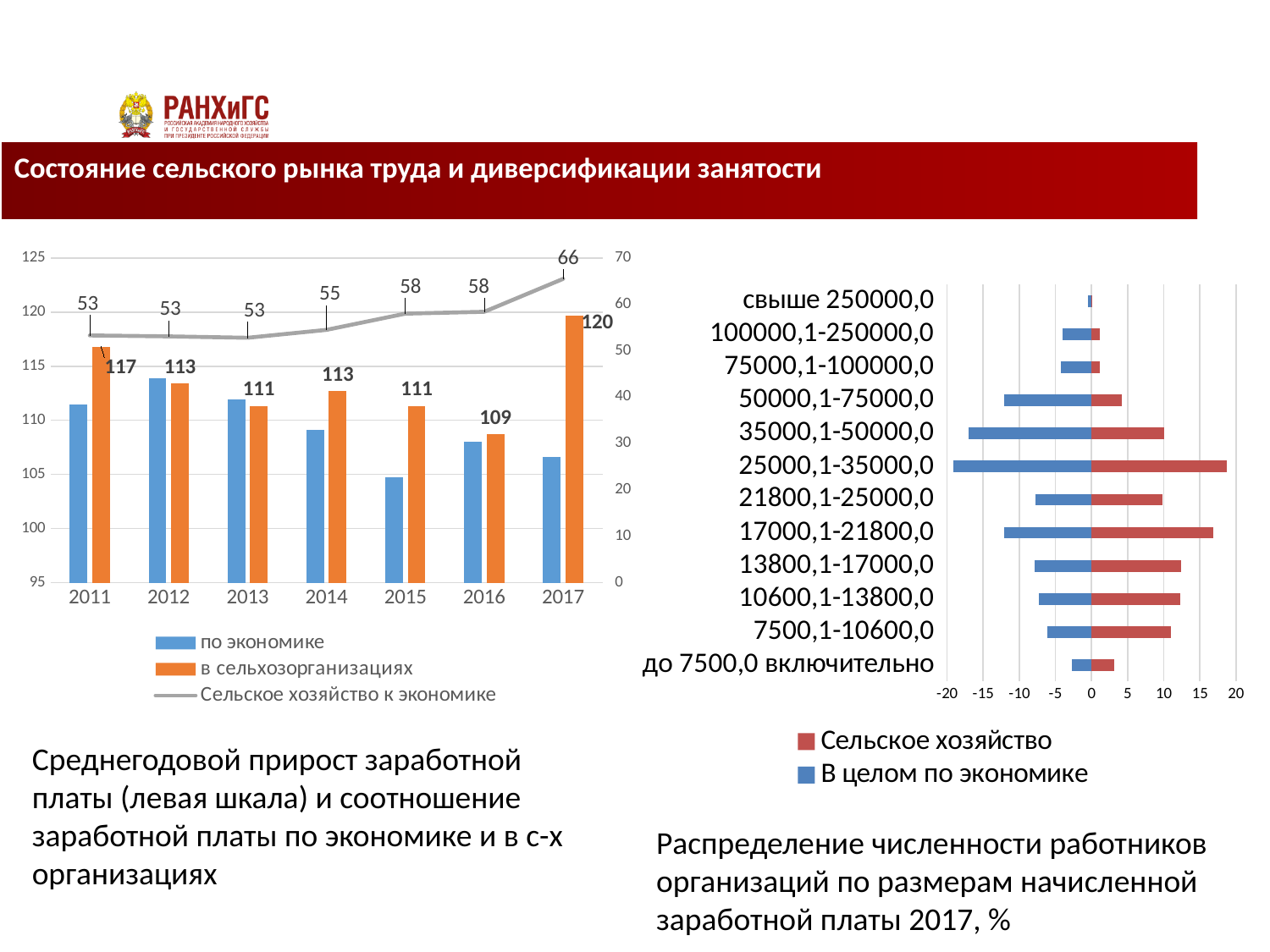
In the left chart, what is the difference between the 'в сельхозорганизациях' values for 2017 and 2016? 11 In the right chart, which category has the largest 'Сельское хозяйство' value? 25000,1-35000,0 How many years are shown on the x axis of the left chart? 7 How many wage-range categories are shown in the right chart? 12 In the left chart, what is the value for 'в сельхозорганизациях' in 2016? 109 In the left chart, does the 'Сельское хозяйство к экономике' line rise or fall from 2011 to 2017? rises In the left chart, which year has the lowest value for 'в сельхозорганизациях'? 2016 In the left chart, which year has the highest value for 'в сельхозорганизациях'? 2017 What kind of chart is the right chart (Распределение численности работников)? bar chart How many series does the legend of the left chart list? 3 In the left chart, what is the value of the 'Сельское хозяйство к экономике' line for 2017? 66 In the left chart, which is larger: the 'в сельхозорганизациях' value for 2011 or for 2012? 2011